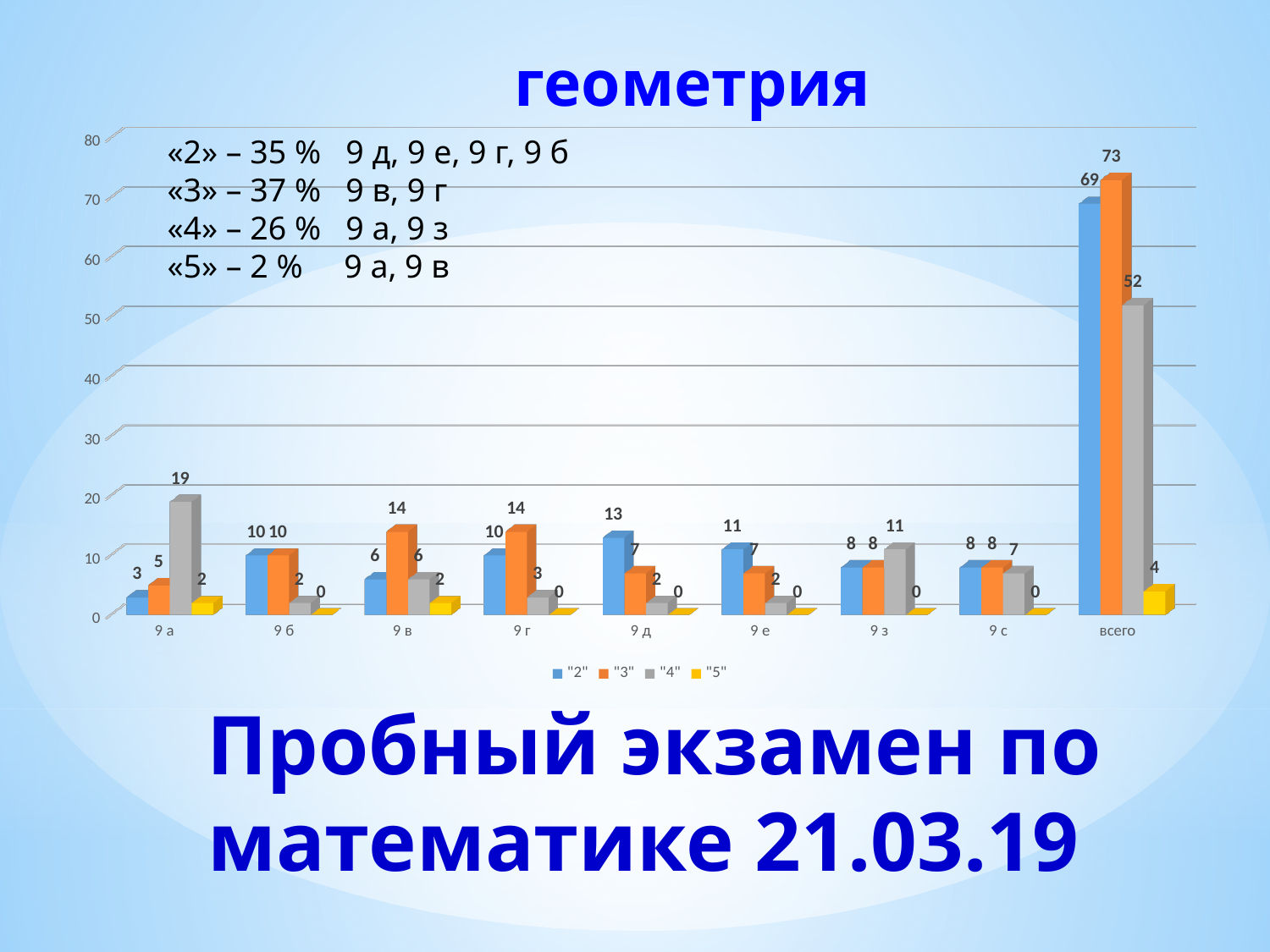
What is the value of series "4" for 9 а? 19 How many categories are shown on the x axis? 9 How many series does the legend list? 4 What is the value of series "5" for всего? 4 What is the title of the chart? геометрия Among the class categories (excluding всего), which has the lowest value for series "2"? 9 а What kind of chart is shown on the slide? bar chart What is the value of series "3" for всего? 73 For 9 в, which is larger: the value for series "3" or series "2"? "3" What is the value of series "2" for 9 д? 13 Which category has the highest value for series "2"? всего What is the difference between the "3" and "2" values for всего? 4